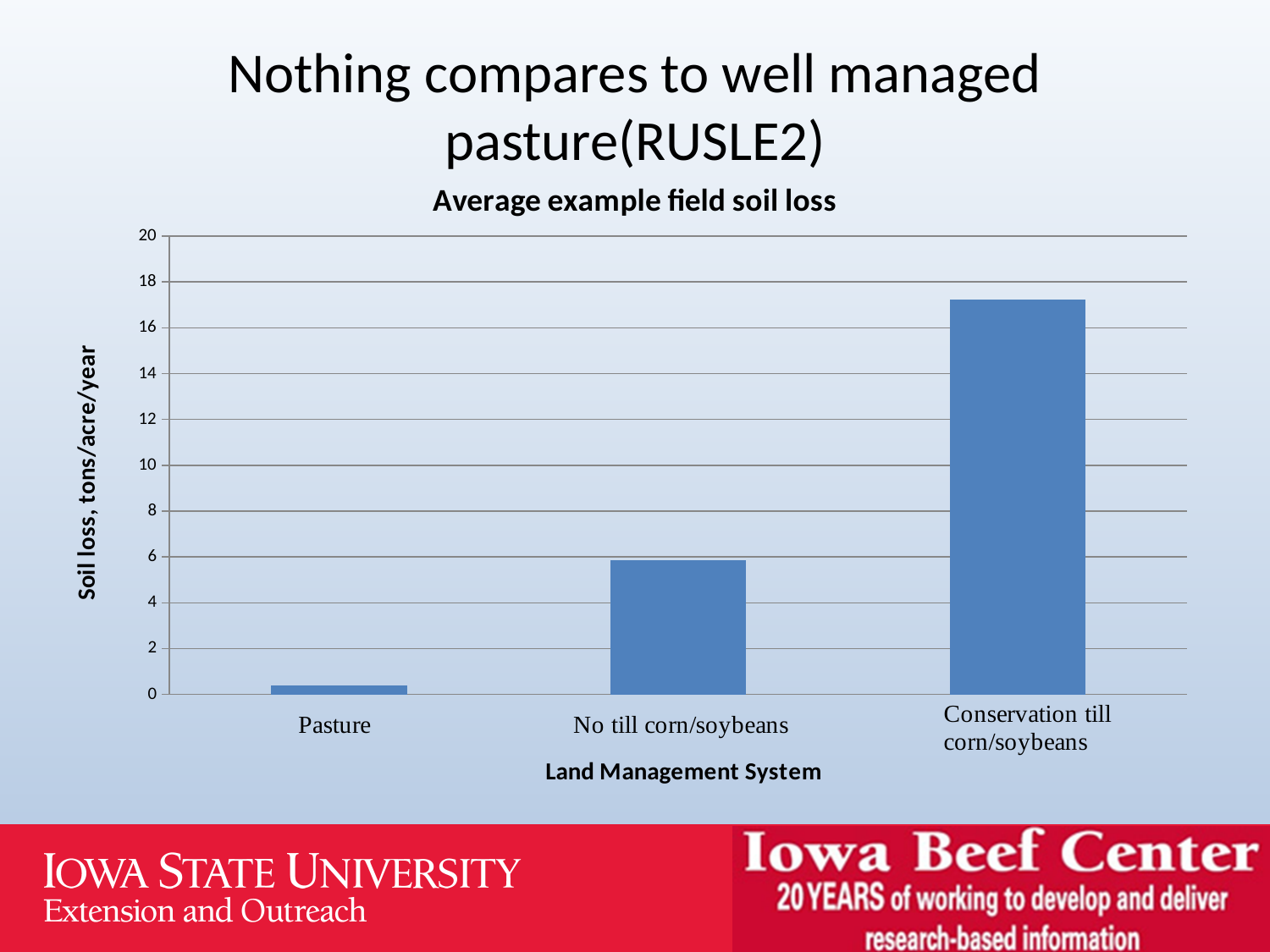
Which land management system has the highest soil loss? Conservation till corn/soybeans What is the title of the chart? Average example field soil loss What type of chart is shown on the slide? bar chart Do the soil loss values rise or fall moving from left to right across the categories? rise Which has a larger soil loss, Pasture or No till corn/soybeans? No till corn/soybeans Which land management system has the lowest soil loss? Pasture Which has a larger soil loss, No till corn/soybeans or Conservation till corn/soybeans? Conservation till corn/soybeans What is the label of the y axis? Soil loss, tons/acre/year Is the soil loss for Conservation till corn/soybeans greater or less than 16 tons/acre/year? greater Is the soil loss for Pasture greater or less than 2 tons/acre/year? less How many land management systems are plotted in the chart? 3